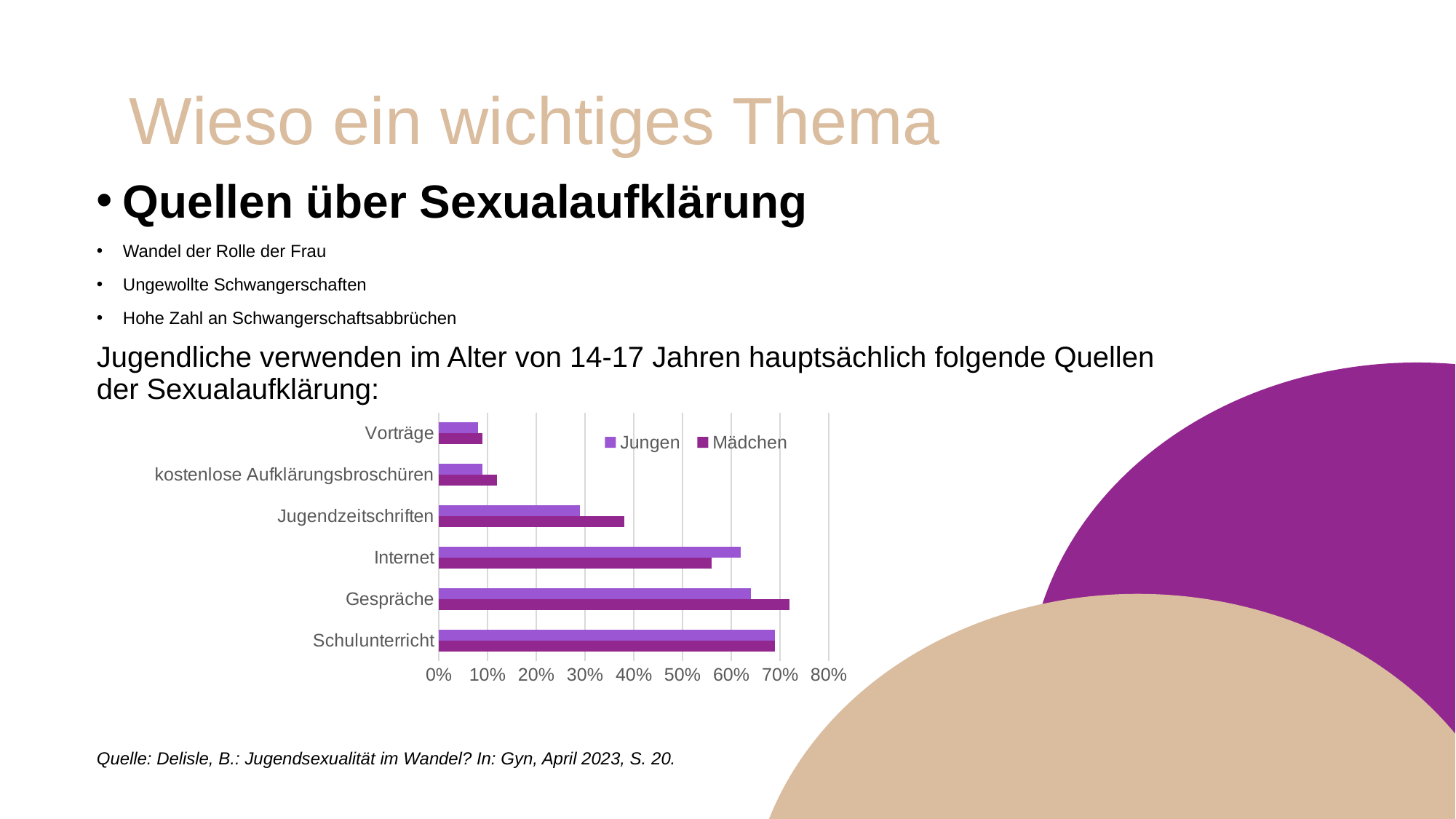
For Jugendzeitschriften, which series has the larger value, Jungen or Mädchen? Mädchen Is the value for Internet (Mädchen) greater or less than 50%? greater Which category has the highest value for Jungen? Schulunterricht Is the value for Schulunterricht (Jungen) greater or less than 60%? greater How many series does the chart's legend list? 2 For Internet, which series has the larger value, Jungen or Mädchen? Jungen Which two series are listed in the chart's legend? Jungen and Mädchen What kind of chart is shown on the slide? bar chart Is the value for Vorträge (Jungen) greater or less than 10%? less Which category has the highest value for Mädchen? Gespräche How many categories (sources) are shown on the chart? 6